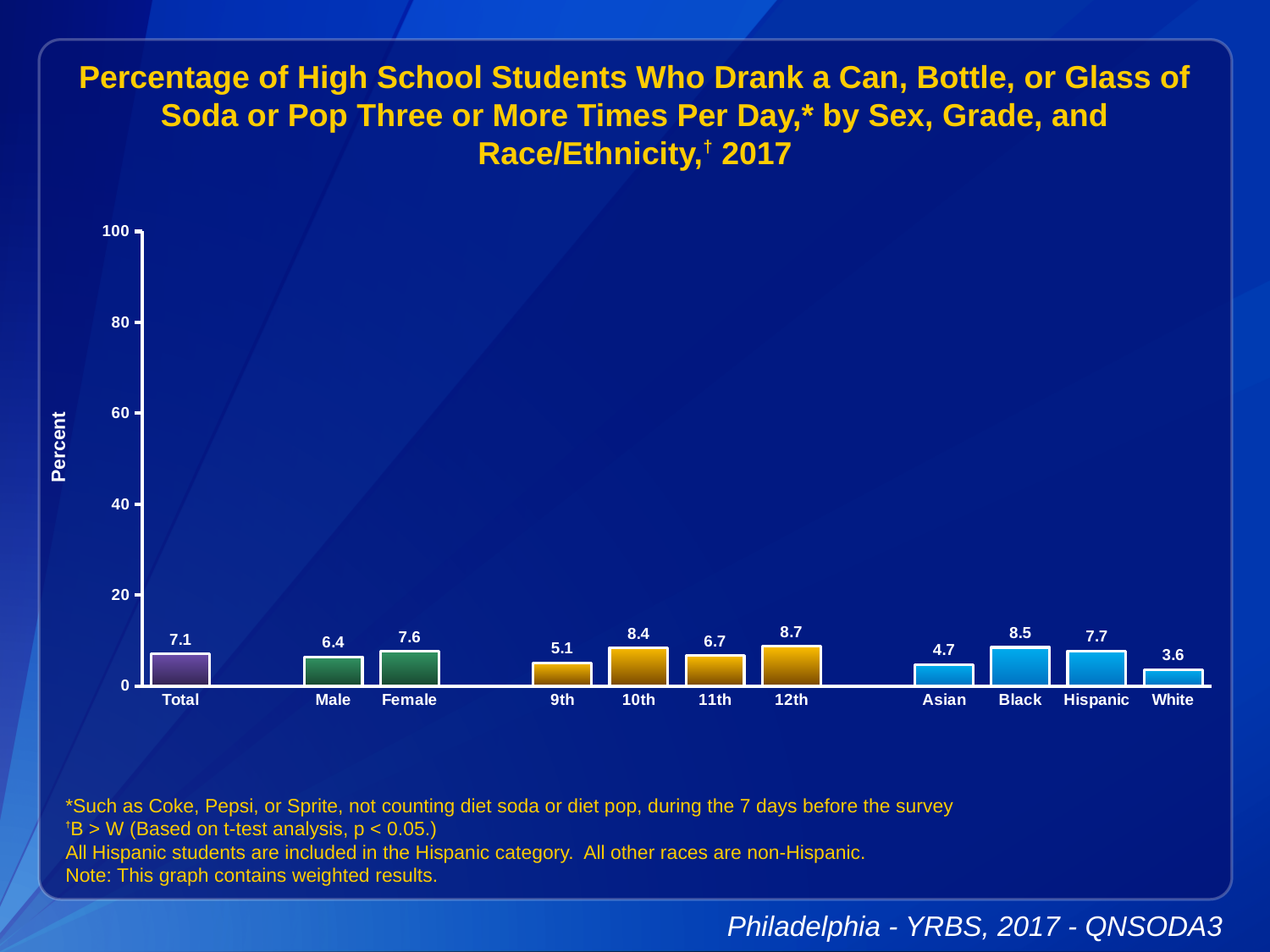
What is the difference between the values for Female and Male? 1.2 What is the value for Total? 7.1 What kind of chart is this? bar chart Is the value for Hispanic greater or less than 20? less What is the value for Female? 7.6 How many categories are shown on the x axis? 11 What is the value for Asian students? 4.7 What is the difference between the values for Black and White? 4.9 What is the value for 12th grade? 8.7 Which category has the highest value? 12th Which category has the lowest value? White Which is larger, the value for 10th grade or 11th grade? 10th